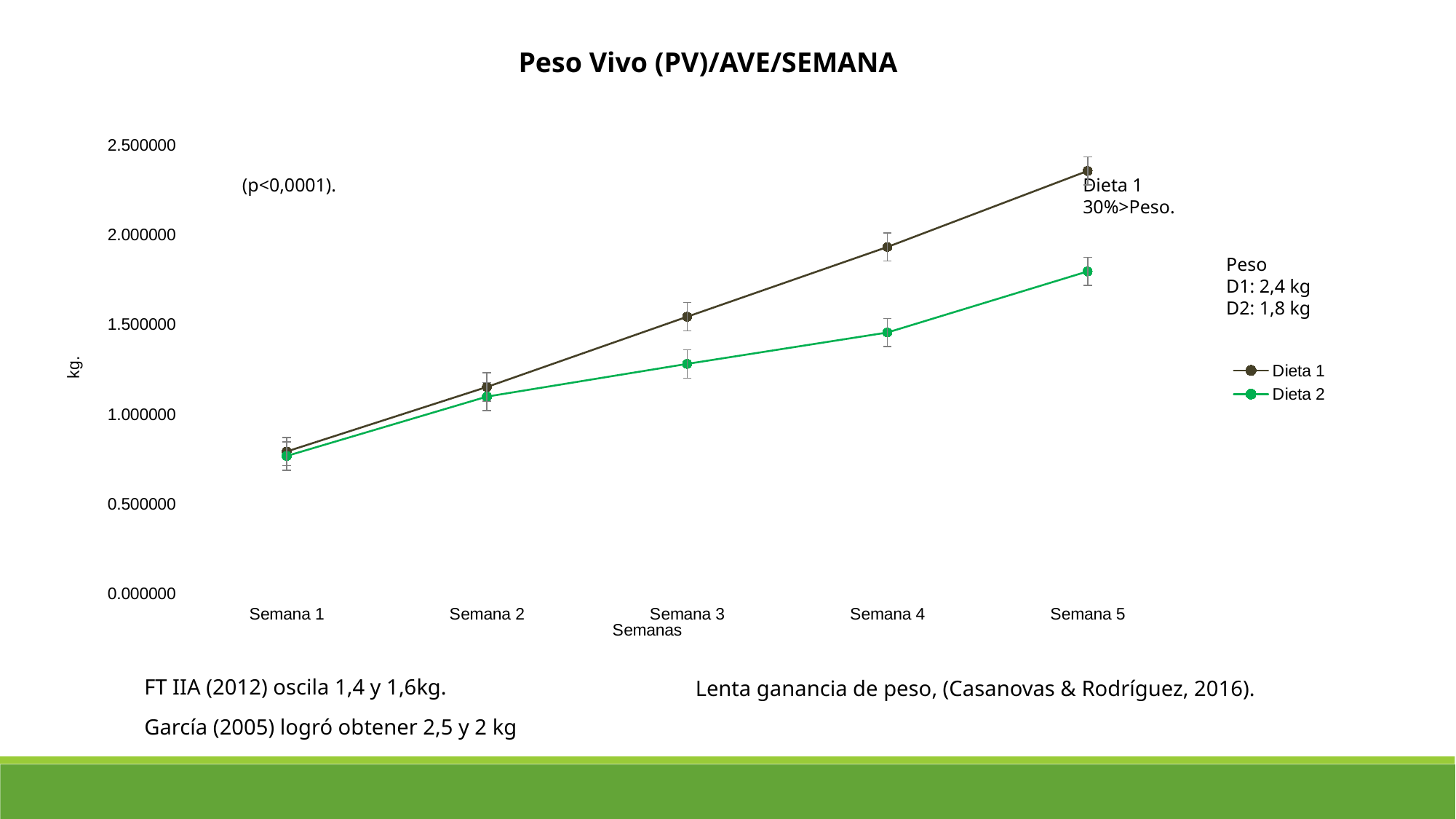
What kind of chart is shown on the slide? line chart At Semana 4, which series has the larger value, Dieta 1 or Dieta 2? Dieta 1 In which week is the value for Dieta 1 highest? Semana 5 How many weeks (categories) are plotted along the x axis? 5 What is the title of the chart? Peso Vivo (PV)/AVE/SEMANA Is the value for Dieta 1 at Semana 5 greater or less than 2.000000? greater In which week is the value for Dieta 2 lowest? Semana 1 Do the values for Dieta 1 rise or fall from Semana 1 to Semana 5? rise How many series does the legend list? 2 At Semana 5, which series has the larger value, Dieta 1 or Dieta 2? Dieta 1 Is the value for Dieta 2 at Semana 3 greater or less than 1.500000? less Is the value for Dieta 1 at Semana 1 greater or less than 1.000000? less